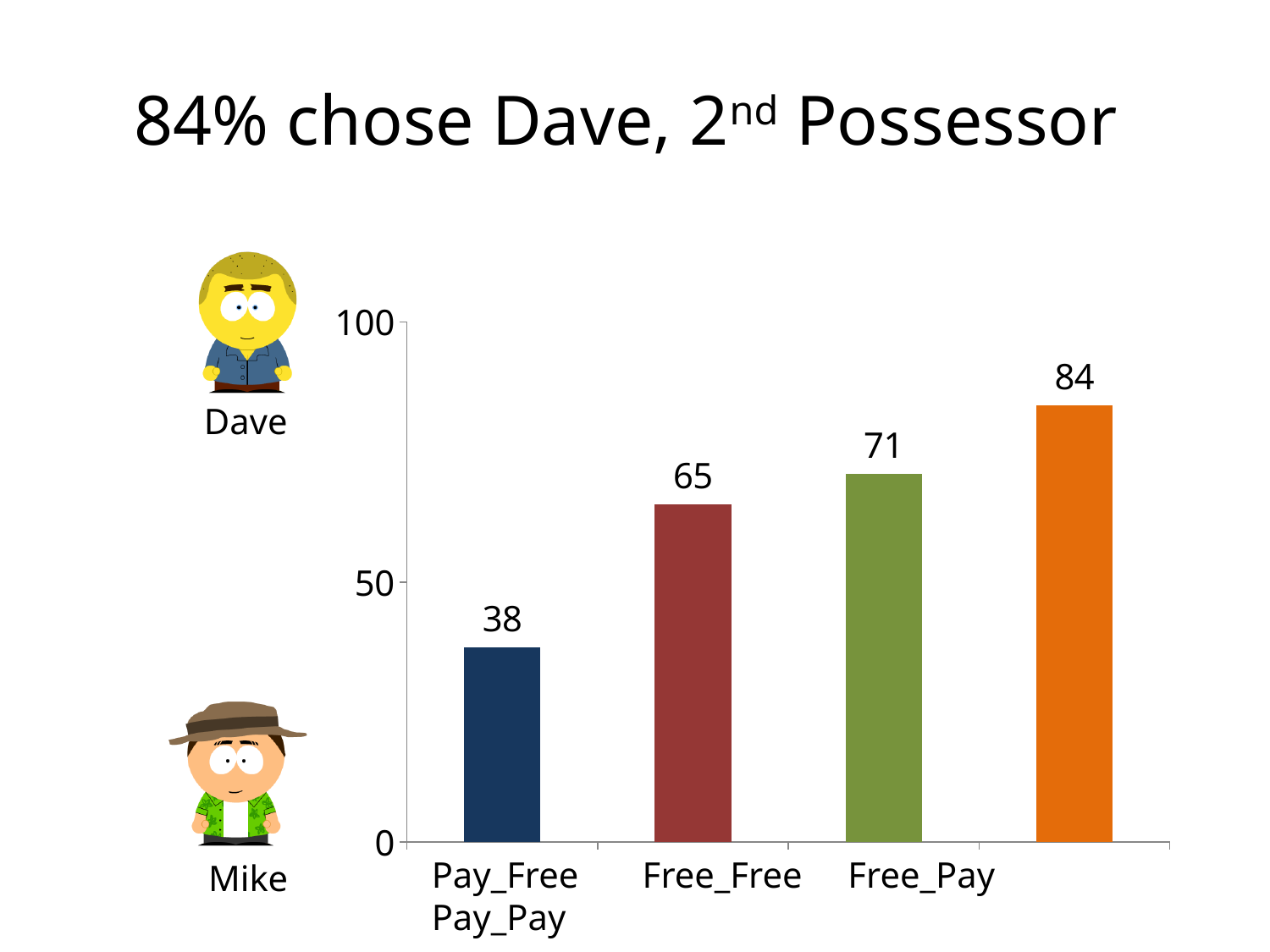
How many bars are in the chart? 4 What is the difference between the values for Free_Pay and Free_Free? 6 What is the value for Pay_Free? 38 Which is larger, the value for Free_Pay or the value for Free_Free? Free_Pay What kind of chart is shown on the slide? bar chart Which category has the lowest value? Pay_Free What is the value for Free_Pay? 71 What is the highest value shown in the chart? 84 What is the difference between the values for Free_Free and Pay_Free? 27 Is the value for Pay_Free greater or less than 50? less What is the value of the rightmost (orange) bar? 84 What is the value for Free_Free? 65